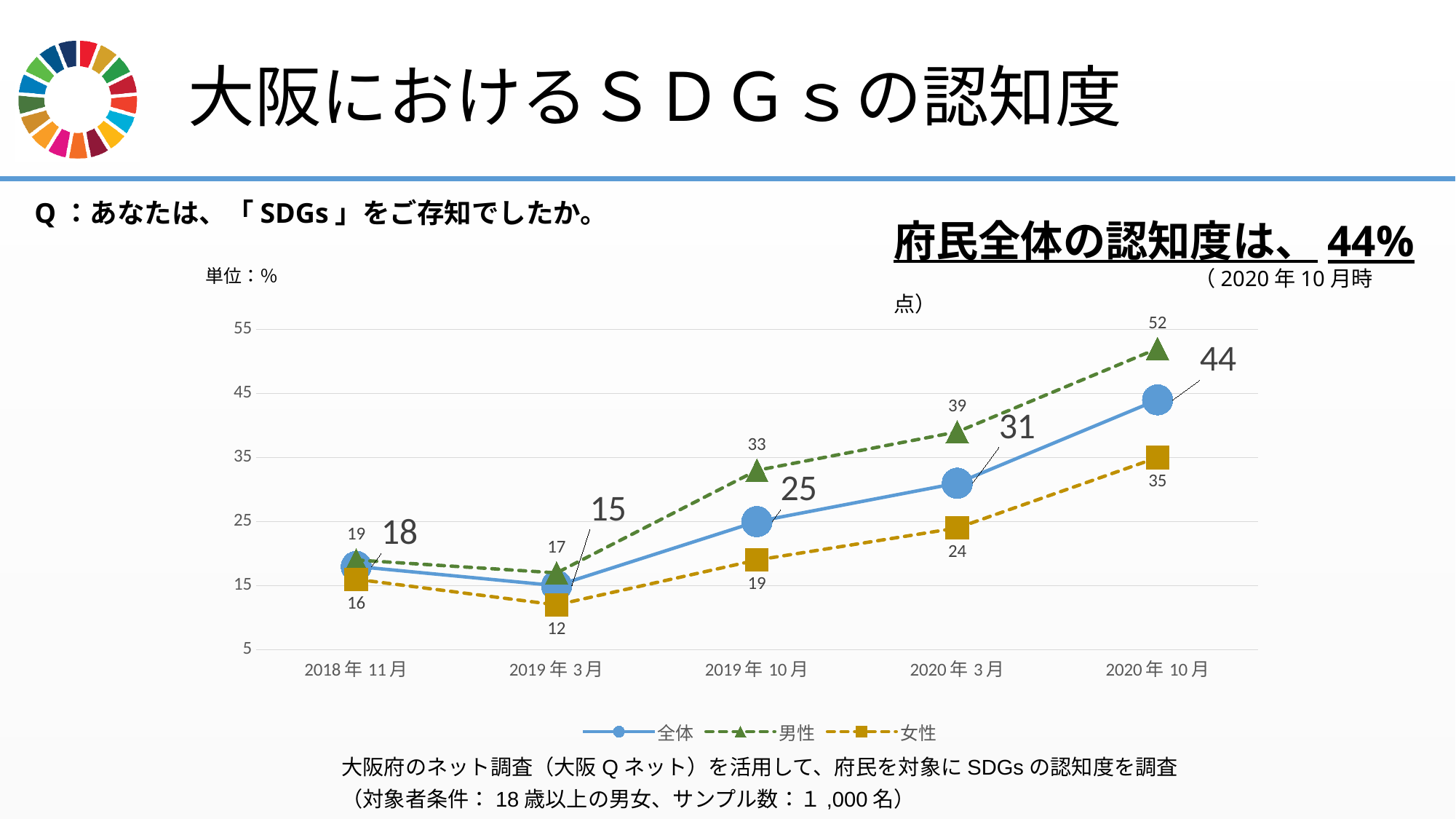
How many series does the legend list? 3 Does the 全体 series rise or fall from 2019年3月 to 2020年10月? rise Which is larger in 2020年3月, 男性 or 女性? 男性 How many time points are plotted on the x axis? 5 What is the value for 女性 in 2019年3月? 12 At which time point is the 男性 series highest? 2020年10月 What is the difference between 男性 and 女性 in 2020年10月? 17 At which time point is the 全体 series lowest? 2019年3月 What type of chart is shown on the slide? line chart What is the value for 全体 in 2020年10月? 44 What is the value for 男性 in 2019年10月? 33 What unit is indicated for the chart values? %